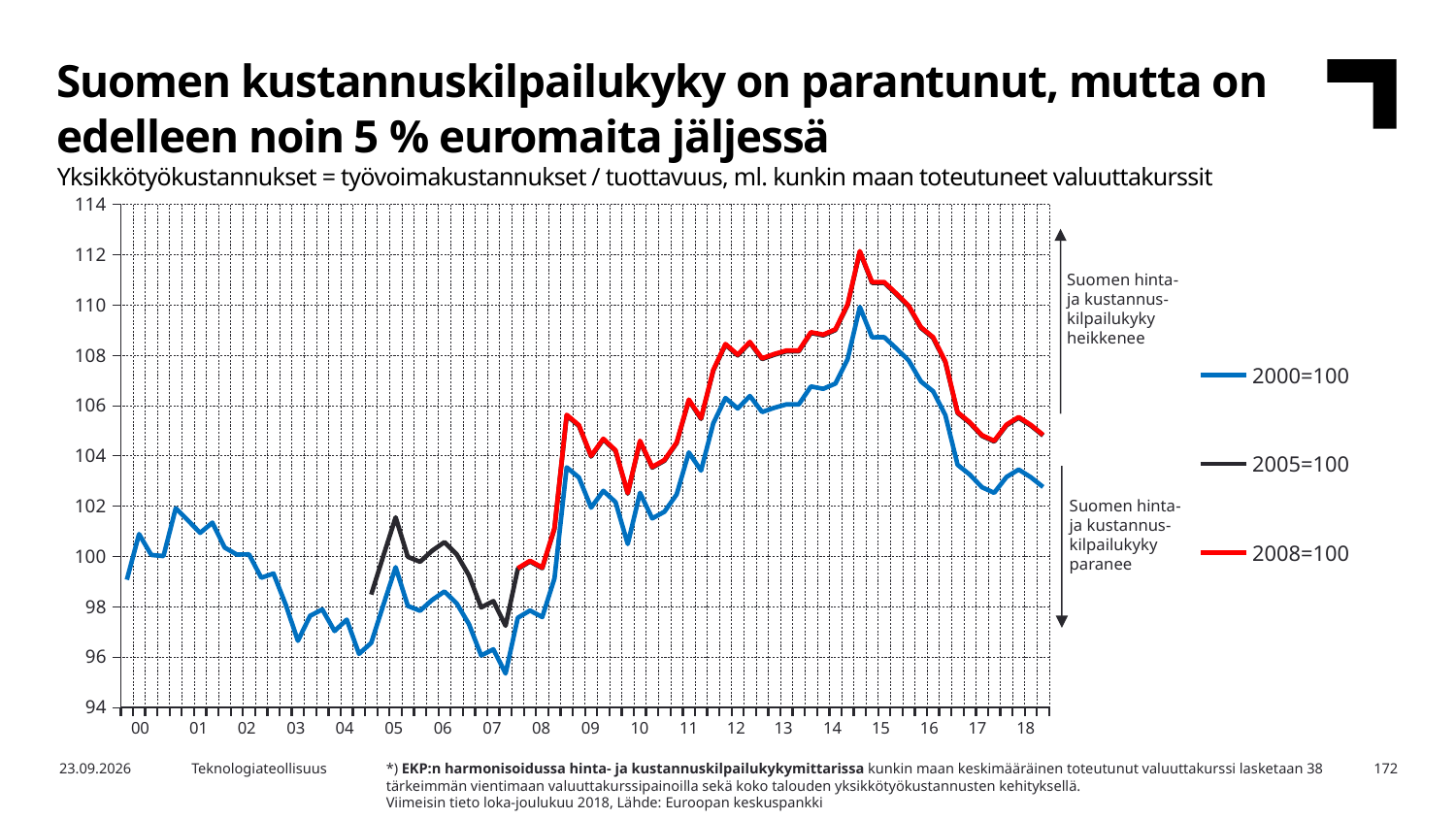
In which year does the 2008=100 series reach its highest value? 2015 How many series does the legend list? 3 At the end of 2018, which series has the higher value, 2000=100 or 2008=100? 2008=100 Which series is drawn in blue according to the legend? 2000=100 What kind of chart is shown on the slide? line chart Is the lowest value of the 2000=100 series (around 2007) greater or less than 96? less Does the 2000=100 series rise or fall between 2014 and 2018? fall Is the peak value of the 2000=100 series (around 2014) greater or less than 108? greater How many year labels are shown on the x axis? 19 Which series is drawn in red according to the legend? 2008=100 Is the final value of the 2008=100 series at the end of 2018 greater or less than 104? greater